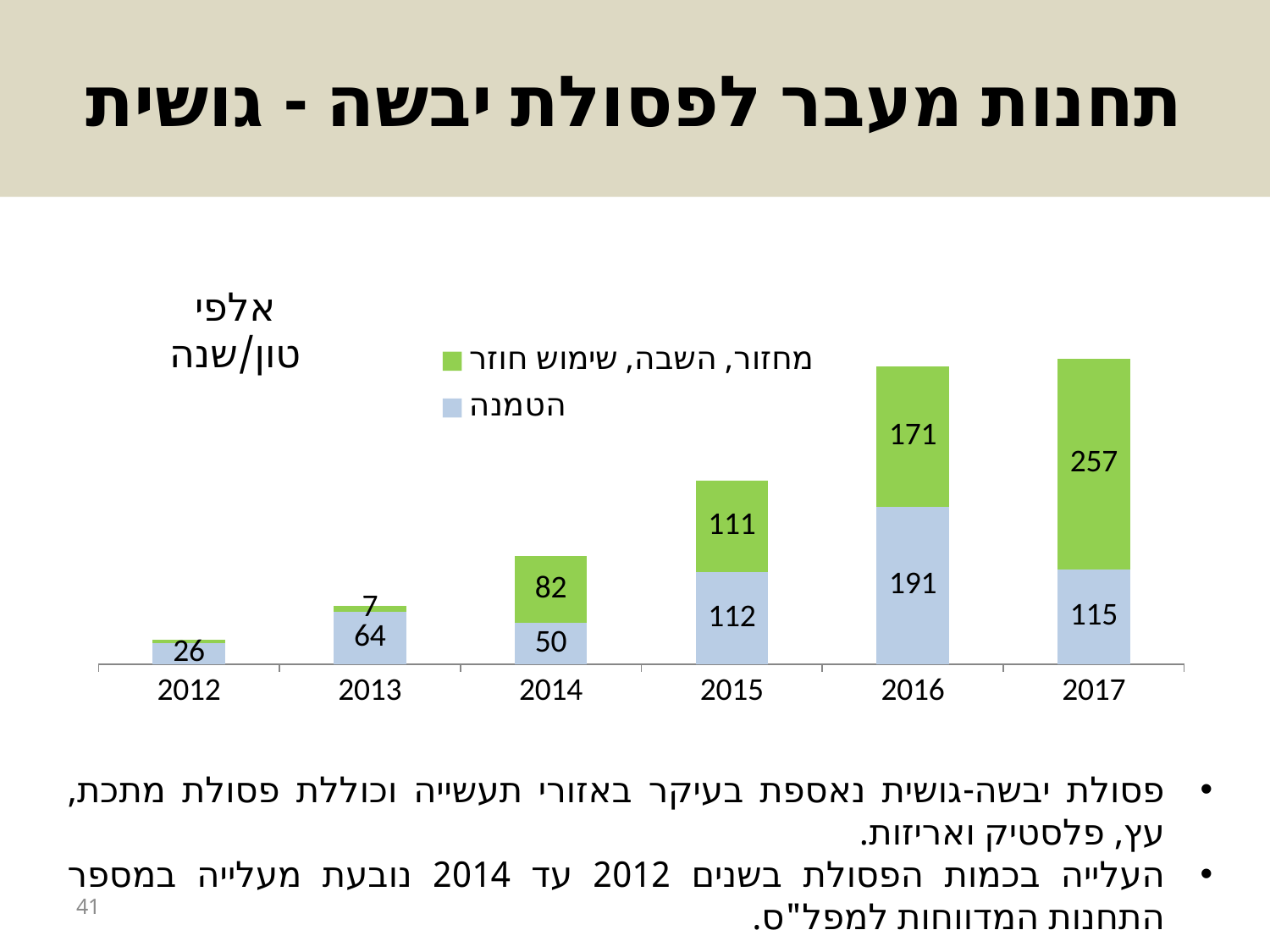
What is the total of the stacked bar for 2017? 372 In which year is the מחזור, השבה, שימוש חוזר (recycling) value lowest among the labeled values? 2013 Which is larger in 2014: the הטמנה value or the מחזור, השבה, שימוש חוזר value? מחזור, השבה, שימוש חוזר What is the value of the מחזור, השבה, שימוש חוזר (recycling) series for 2017? 257 What type of chart is shown on the slide? stacked bar chart How many series does the legend list? 2 What is the value of the הטמנה series for 2012? 26 What is the total of the stacked bar for 2015? 223 What is the value of the מחזור, השבה, שימוש חוזר series for 2013? 7 In which year is the הטמנה (landfill) value highest? 2016 What is the difference between the הטמנה values for 2016 and 2017? 76 What is the value of the הטמנה (landfill) series for 2016? 191